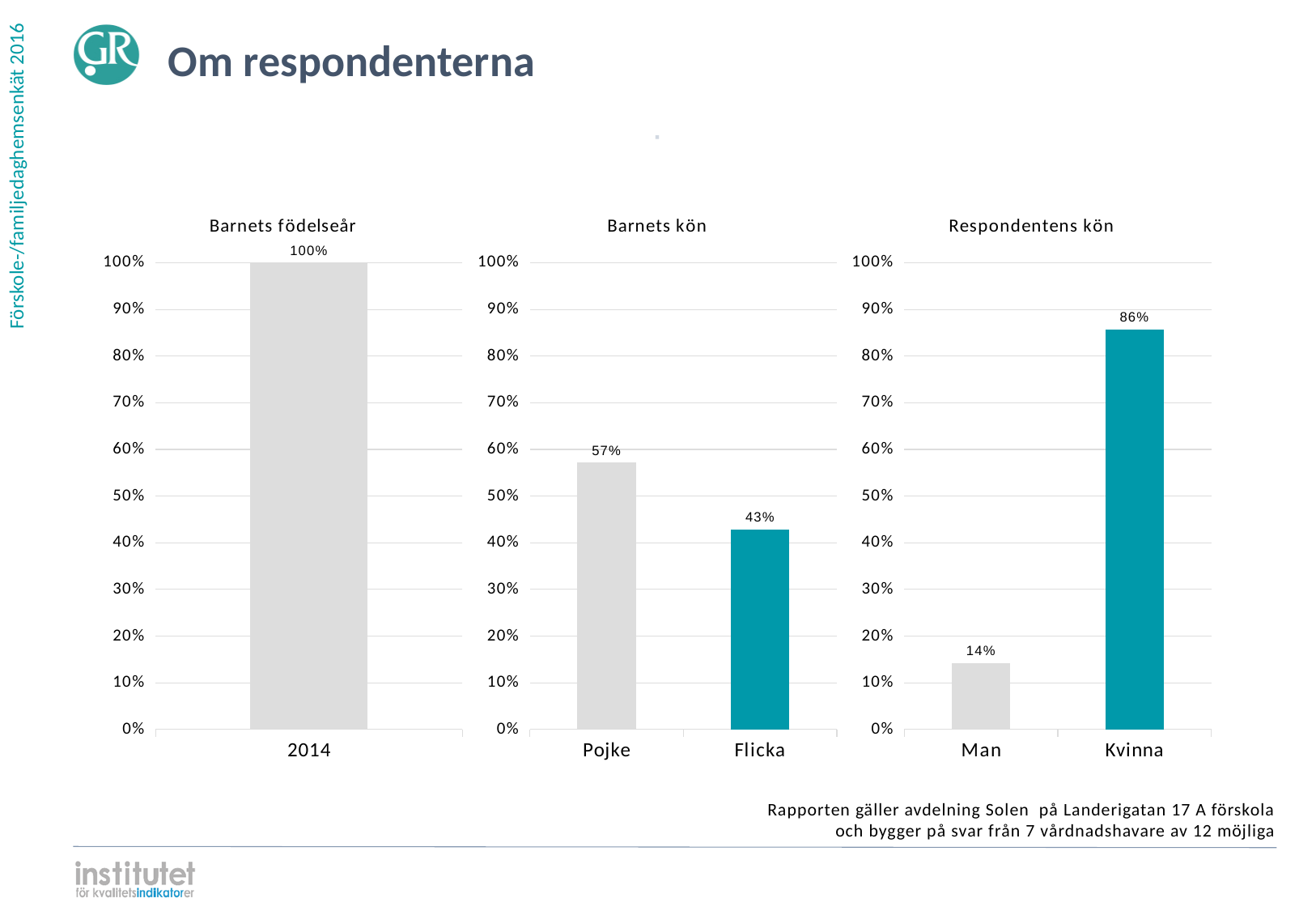
In the 'Respondentens kön' chart, is the value for Man greater or less than 20%? less How many categories are shown in the 'Barnets kön' chart? 2 In the 'Barnets kön' chart, what is the value for Flicka? 43% In the 'Barnets kön' chart, what is the difference between the values for Pojke and Flicka? 14% In the 'Respondentens kön' chart, what is the value for Man? 14% In the 'Respondentens kön' chart, what is the value for Kvinna? 86% In the 'Barnets födelseår' chart, what is the value for 2014? 100% In the 'Barnets kön' chart, what is the value for Pojke? 57% In the 'Respondentens kön' chart, what is the difference between the values for Kvinna and Man? 72% In the 'Respondentens kön' chart, which category has the highest value? Kvinna What kind of chart is the 'Barnets födelseår' chart? Bar chart In the 'Barnets kön' chart, which category has the lowest value? Flicka